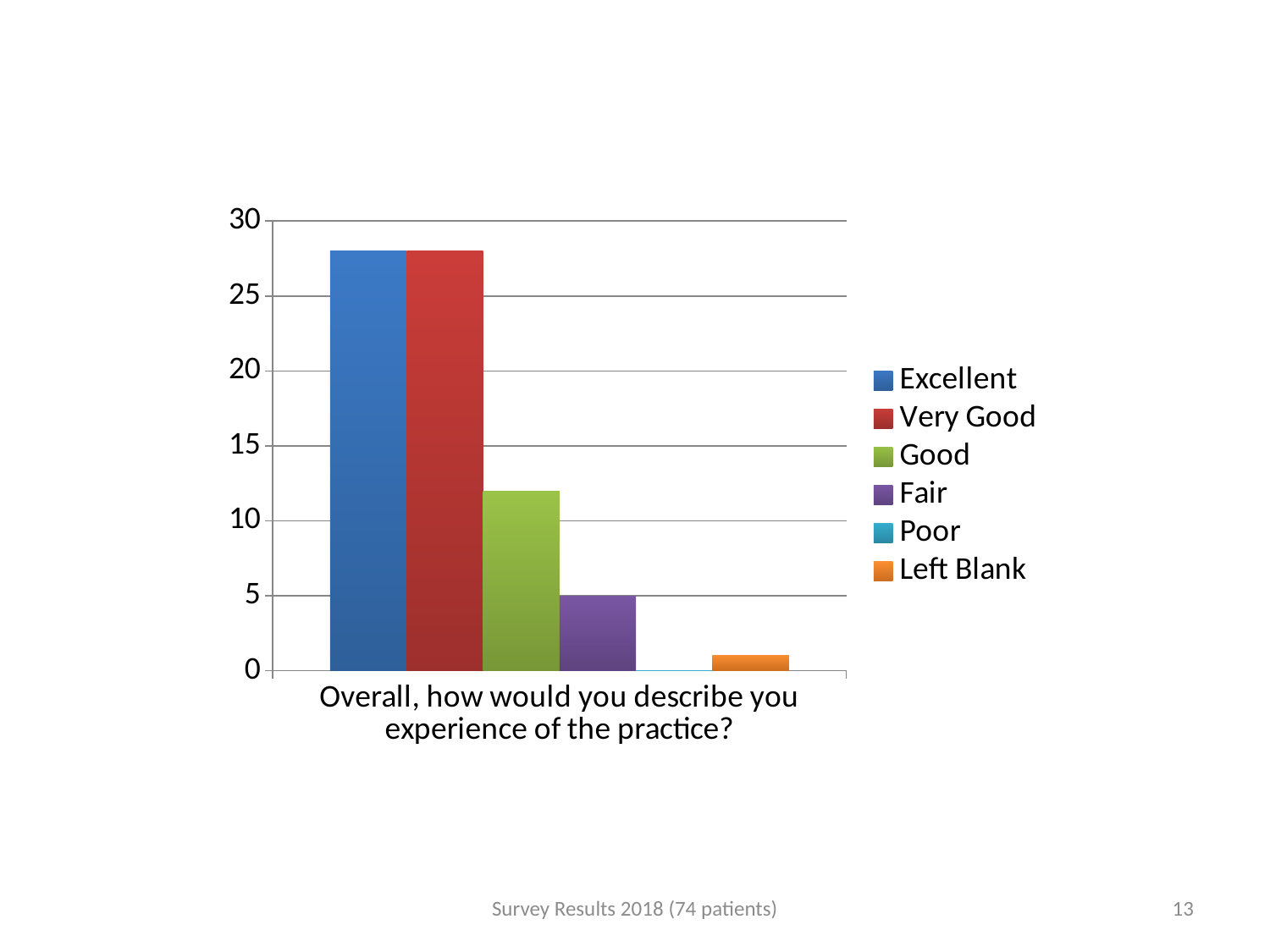
Which is larger, the value for Very Good or the value for Good? Very Good What is the category label shown on the x axis? Overall, how would you describe you experience of the practice? What is the value for Fair? 5 Is the value for Left Blank greater or less than 5? less How many series does the legend list? 6 Is the value for Good greater or less than 10? greater What kind of chart is shown on the slide? bar chart Which is larger, the value for Good or the value for Fair? Good Which series has the lowest value? Poor Is the value for Excellent greater or less than 25? greater How many categories are shown on the x axis? 1